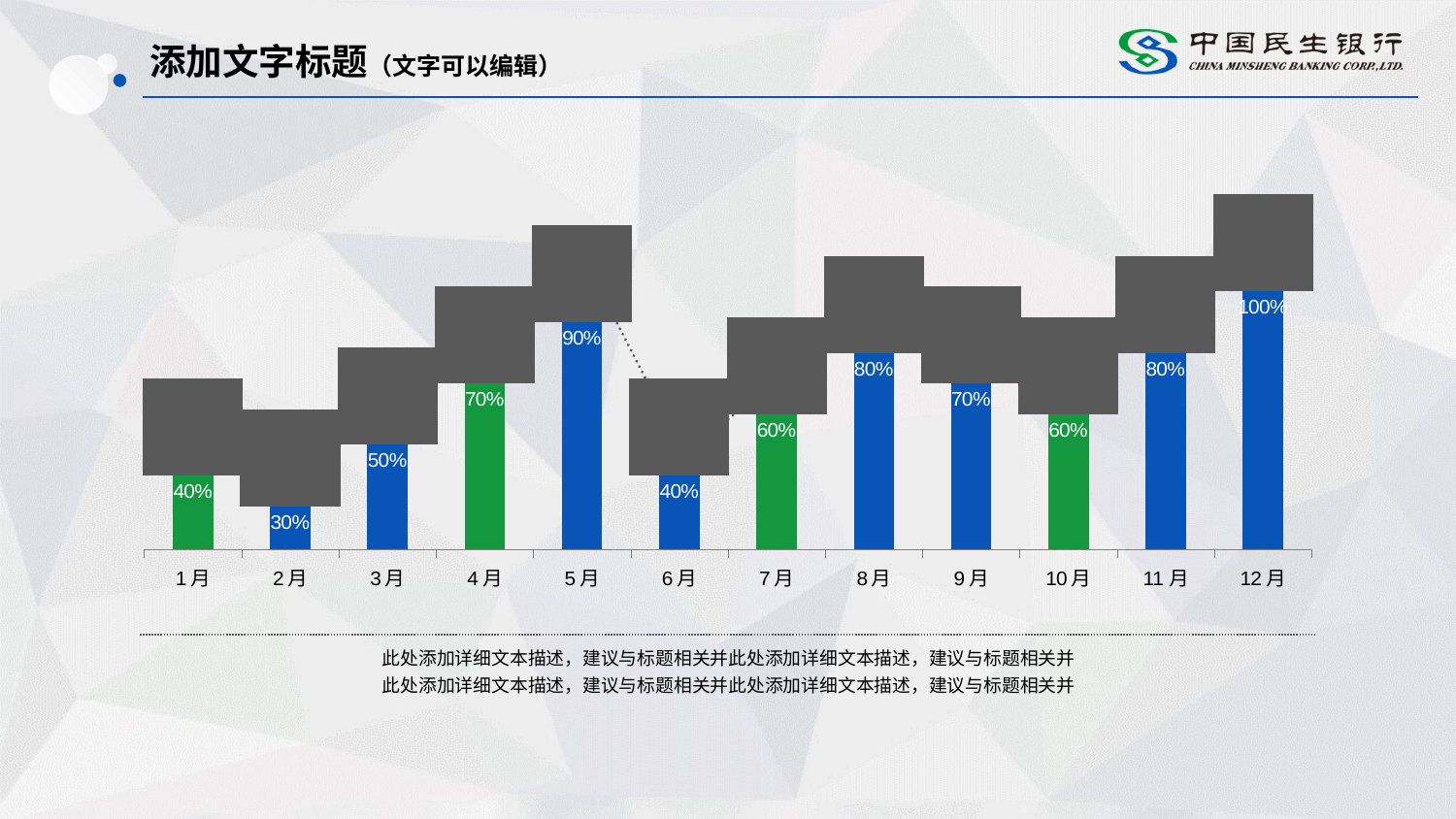
What is the value for 10月? 60% What is the value for 2月? 30% What is the difference between the values for 12月 and 6月? 60% How many months are shown on the x axis? 12 Which month has the highest value? 12月 What kind of chart is shown on the slide? bar chart What is the difference between the values for 5月 and 4月? 20% What is the value for 9月? 70% Which is larger, the value for 8月 or the value for 7月? 8月 What is the value for 5月? 90% Which month has the lowest value? 2月 What colour is the bar for 4月? green